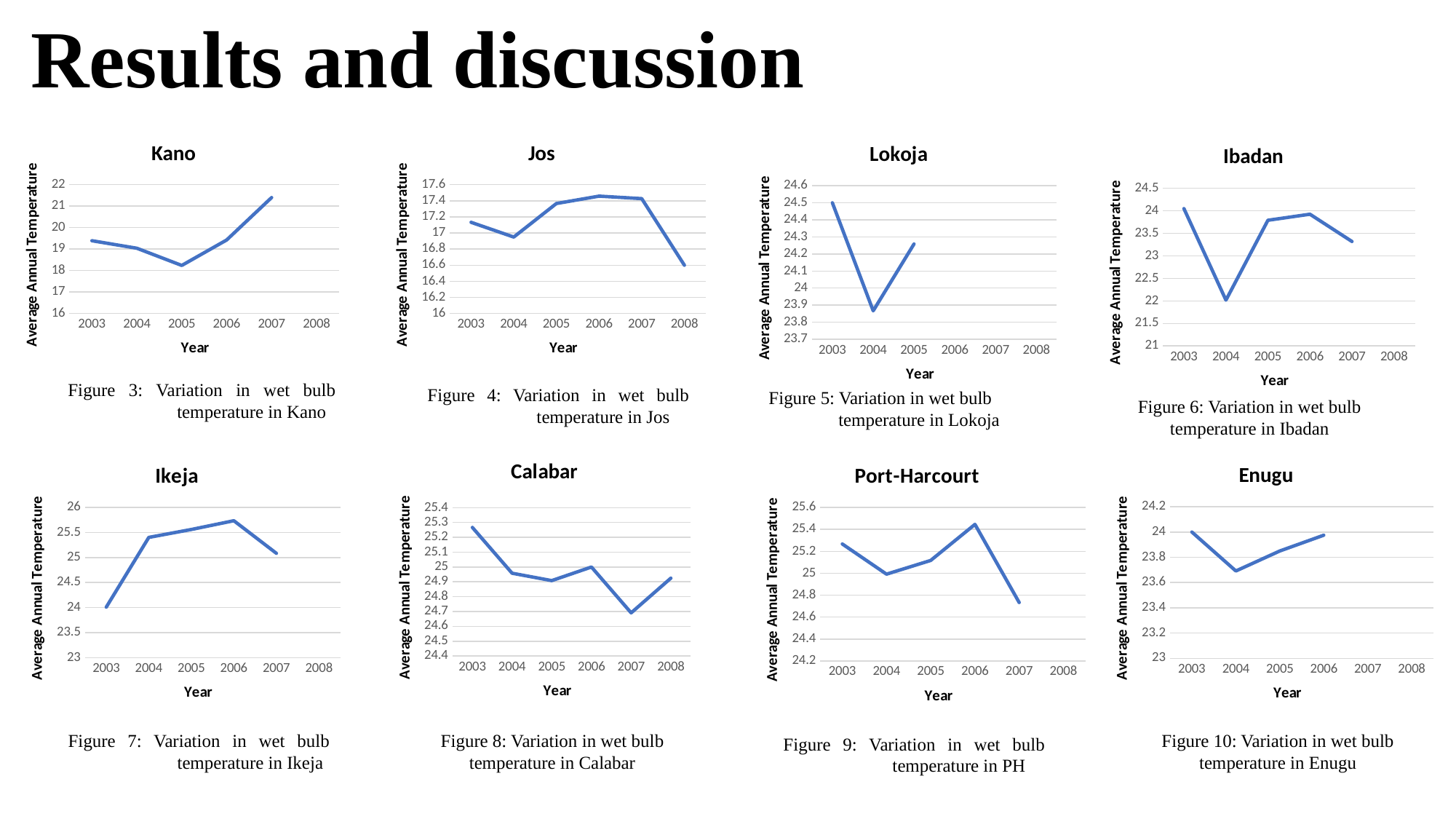
In the Port-Harcourt chart, which is larger, the value for 2006 or the value for 2007? 2006 What is the label of the x axis on the Enugu chart? Year What kind of chart is the Kano chart? line chart In the Jos chart, is the value for 2008 greater or less than 17? less In the Calabar chart, which year has the lowest average annual temperature? 2007 In the Kano chart, which year has the lowest average annual temperature? 2005 In the Ikeja chart, which year has the highest average annual temperature? 2006 In the Kano chart, which year has the highest average annual temperature? 2007 In the Lokoja chart, which year has the lowest average annual temperature? 2004 In the Ibadan chart, is the value for 2004 greater or less than 22.5? less